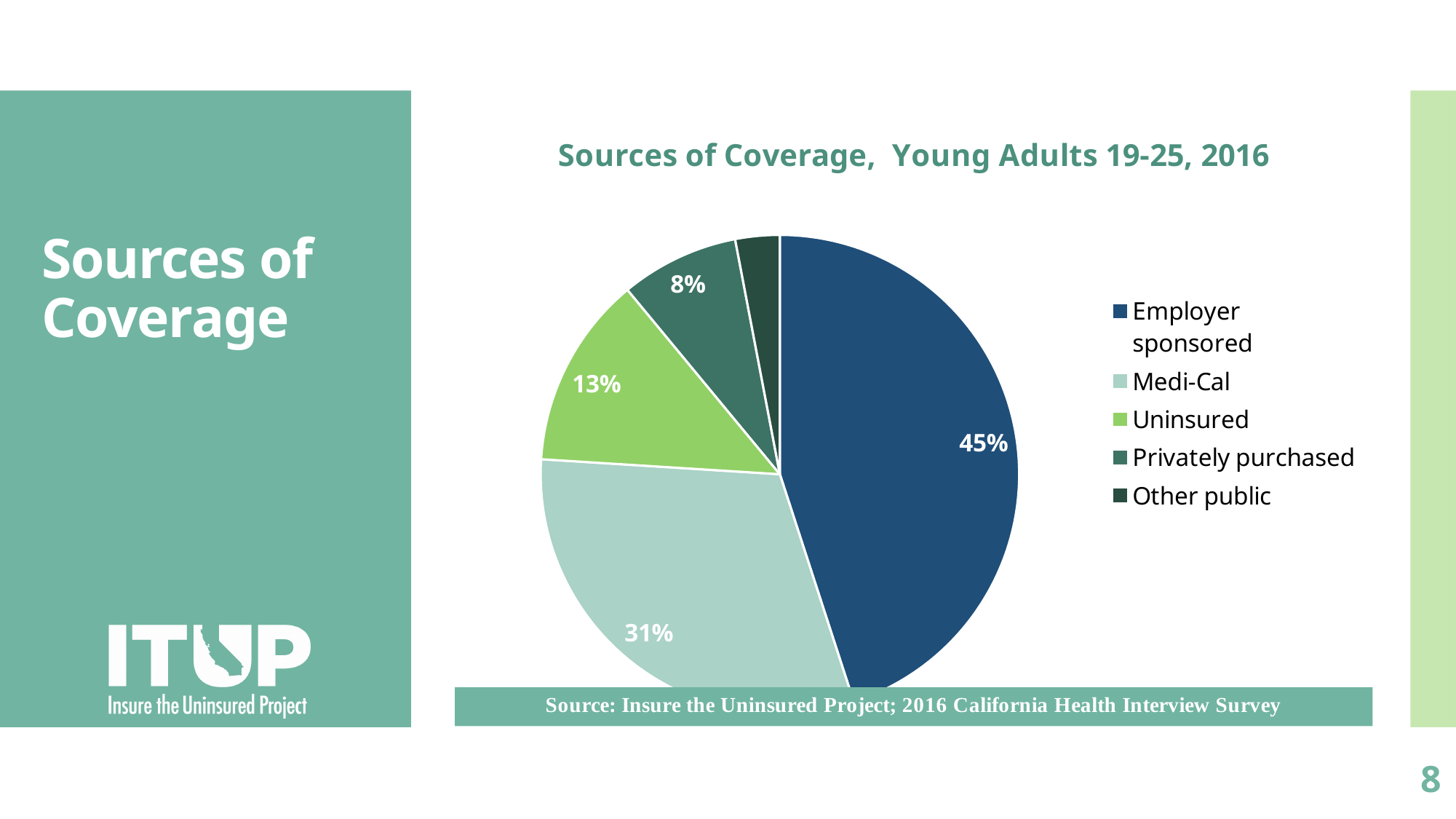
What colour is the Medi-Cal slice? Light green What percentage of young adults 19-25 were uninsured? 13% Which source of coverage has the largest share of the pie? Employer sponsored What share of young adults had privately purchased coverage? 8% What percentage of young adults 19-25 were covered by Medi-Cal? 31% Which source of coverage has the smallest share of the pie? Other public What share of young adults 19-25 had employer sponsored coverage in 2016? 45% What is the title of the chart? Sources of Coverage, Young Adults 19-25, 2016 How many categories does the legend list? 5 Which is larger, the share for Uninsured or the share for Privately purchased? Uninsured What type of chart is shown on the slide? Pie chart What is the difference in percentage points between employer sponsored coverage and Medi-Cal? 14 percentage points